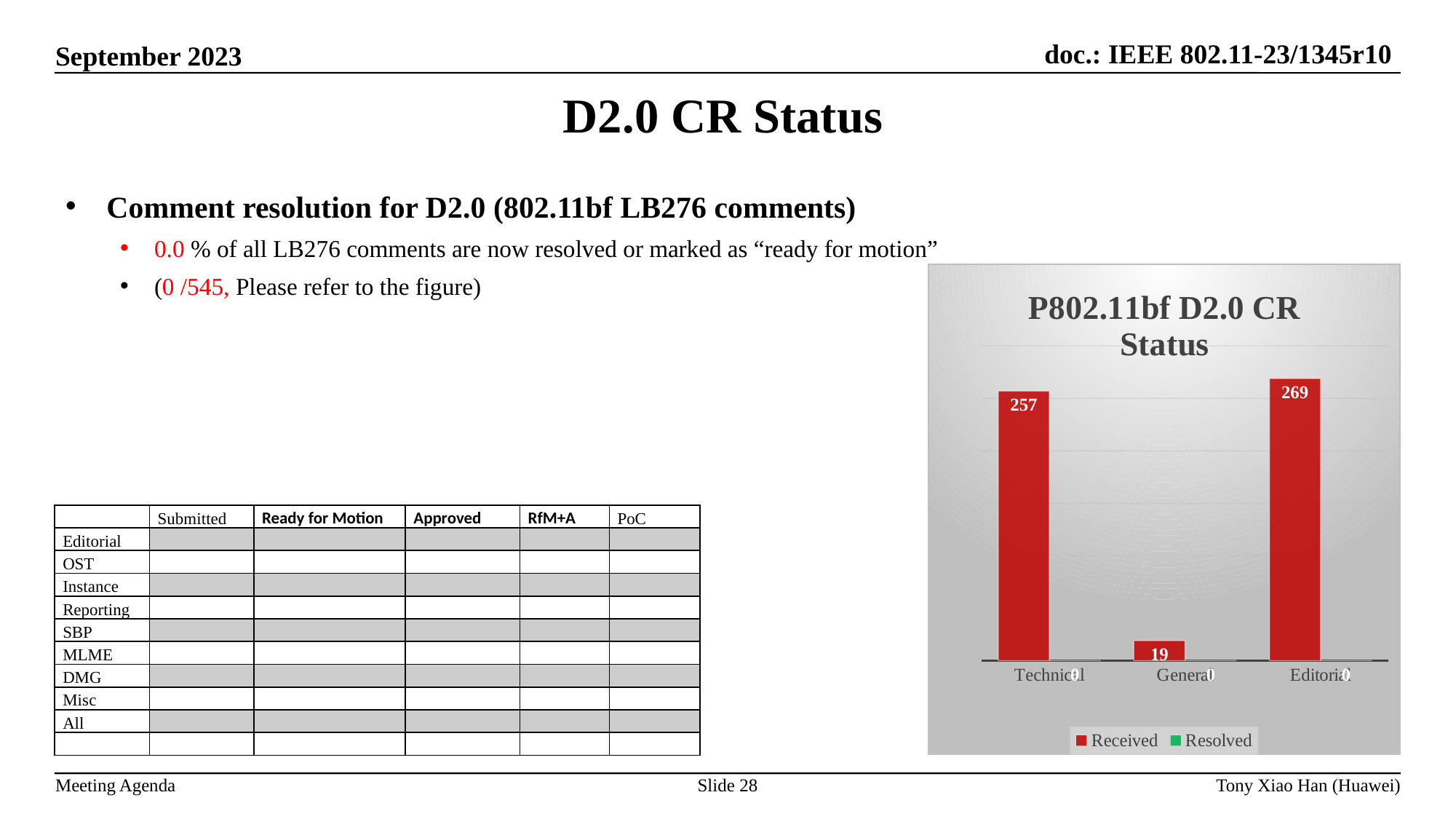
Which category has the highest Received value? Editorial What is the difference between the Received values for Editorial and Technical? 12 What is the Received value for Technical? 257 How many series does the chart legend list? 2 How many categories are shown on the x axis of the chart? 3 Which is larger, the Received value for Technical or for General? Technical What is the Resolved value for Technical? 0 What type of chart is shown on the slide? bar chart What is the Received value for General? 19 What is the Received value for Editorial? 269 Which category has the lowest Received value? General What is the title of the chart? P802.11bf D2.0 CR Status